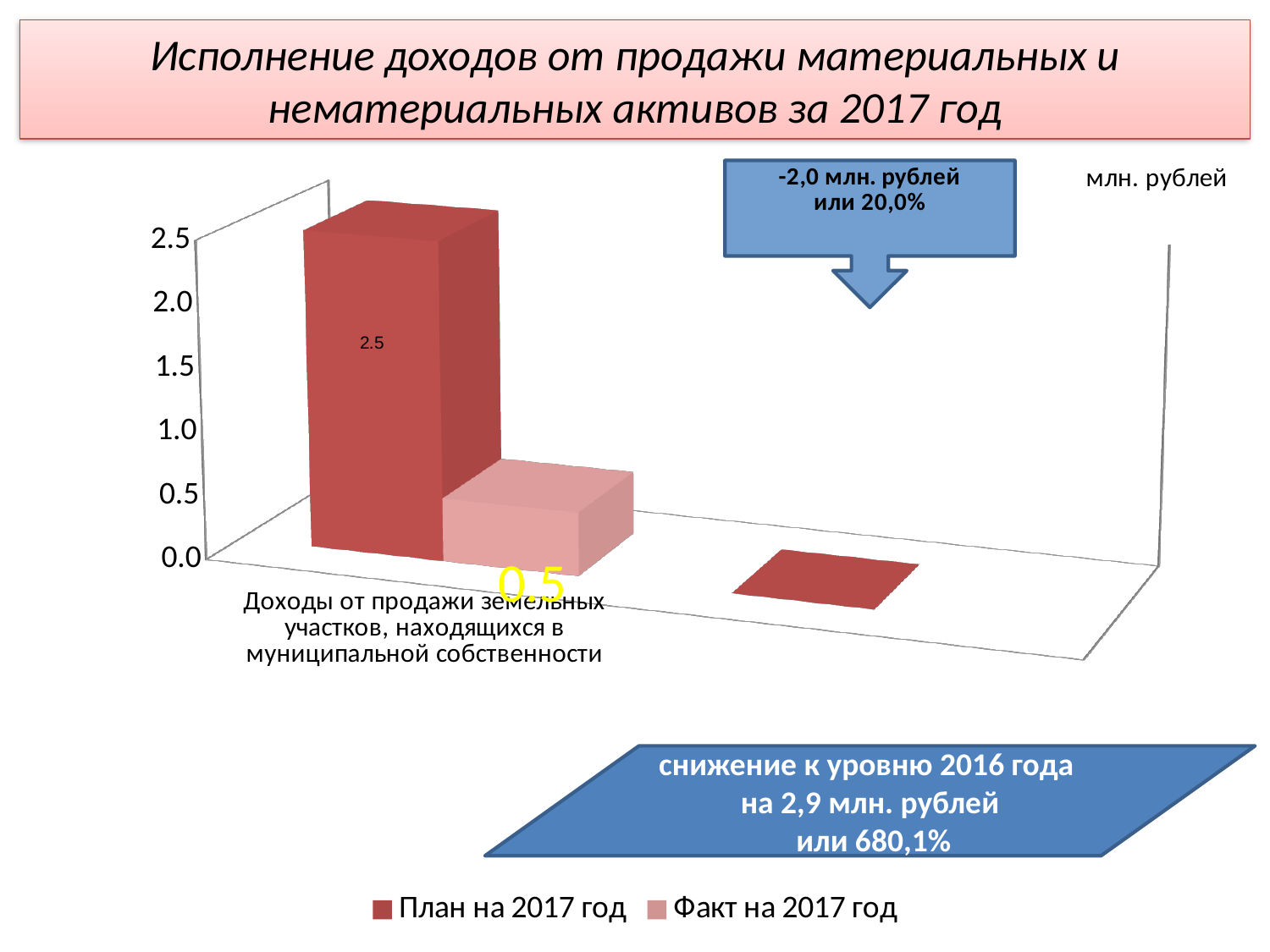
What unit is indicated for the chart values? млн. рублей Is the 'План на 2017 год' value for 'Доходы от продажи земельных участков, находящихся в муниципальной собственности' greater or less than 2.0? greater What is the value of 'План на 2017 год' for 'Доходы от продажи земельных участков, находящихся в муниципальной собственности'? 2.5 What is the value of 'Факт на 2017 год' for 'Доходы от продажи земельных участков, находящихся в муниципальной собственности'? 0.5 What is the highest value shown on the vertical axis? 2.5 What is the difference between the 'План на 2017 год' and 'Факт на 2017 год' values for 'Доходы от продажи земельных участков, находящихся в муниципальной собственности'? 2.0 How many series does the legend list? 2 Which series has the higher value for 'Доходы от продажи земельных участков, находящихся в муниципальной собственности': 'План на 2017 год' or 'Факт на 2017 год'? План на 2017 год What kind of chart is shown on the slide? bar chart Is the 'Факт на 2017 год' value for 'Доходы от продажи земельных участков, находящихся в муниципальной собственности' greater or less than 1.0? less